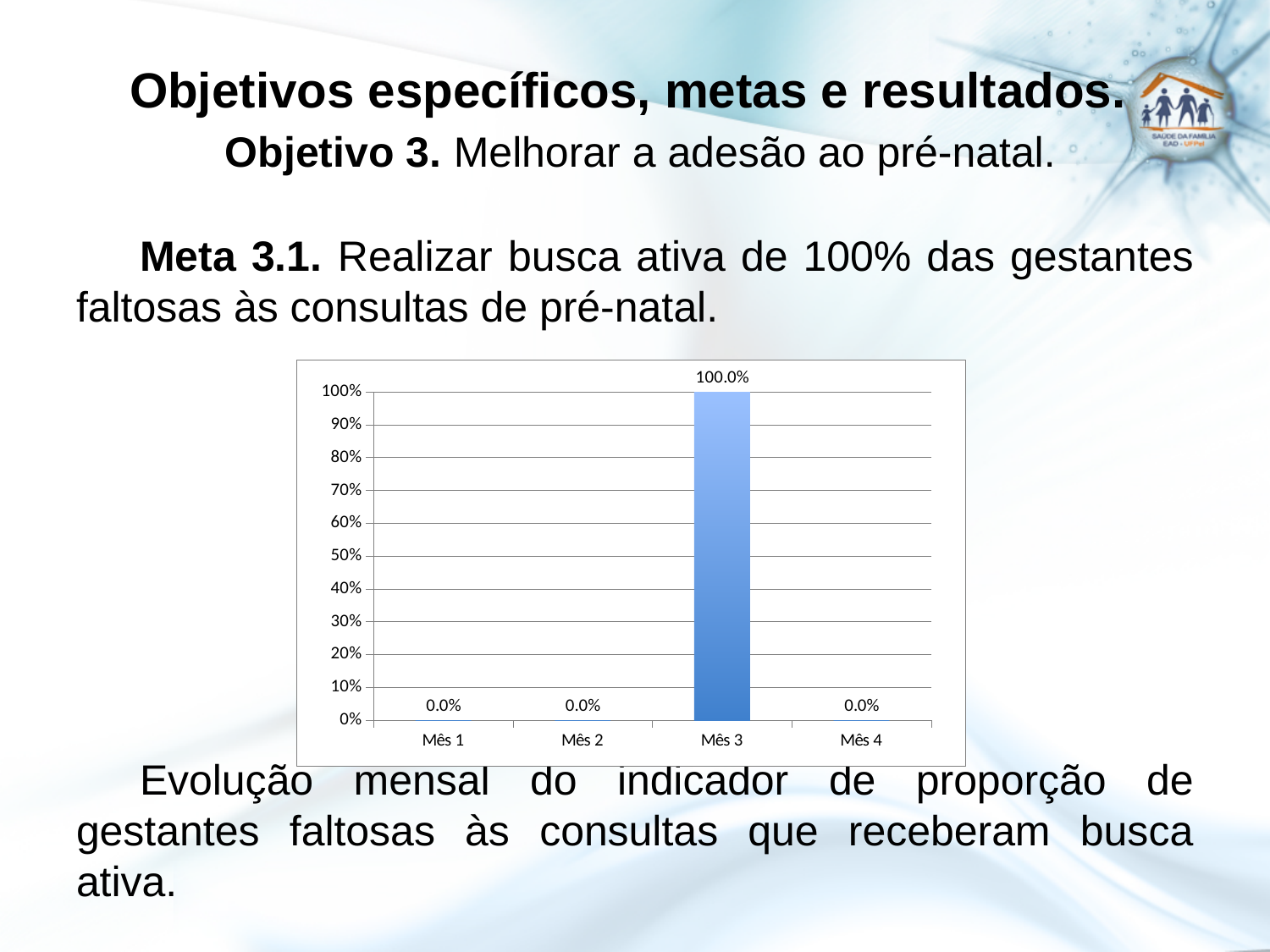
Is the value for Mês 3 greater or less than 50%? greater How many months have a value of 0.0%? 3 What is the label of the third category on the x axis? Mês 3 What kind of chart is shown on the slide? bar chart What is the difference between the values for Mês 3 and Mês 2? 100.0% What is the value for Mês 4? 0.0% Which is larger, the value for Mês 3 or the value for Mês 4? Mês 3 What is the highest value shown on the y axis of the chart? 100% What is the value for Mês 3? 100.0% How many months are shown on the x axis of the chart? 4 What is the value for Mês 1? 0.0% Which month has the highest value? Mês 3